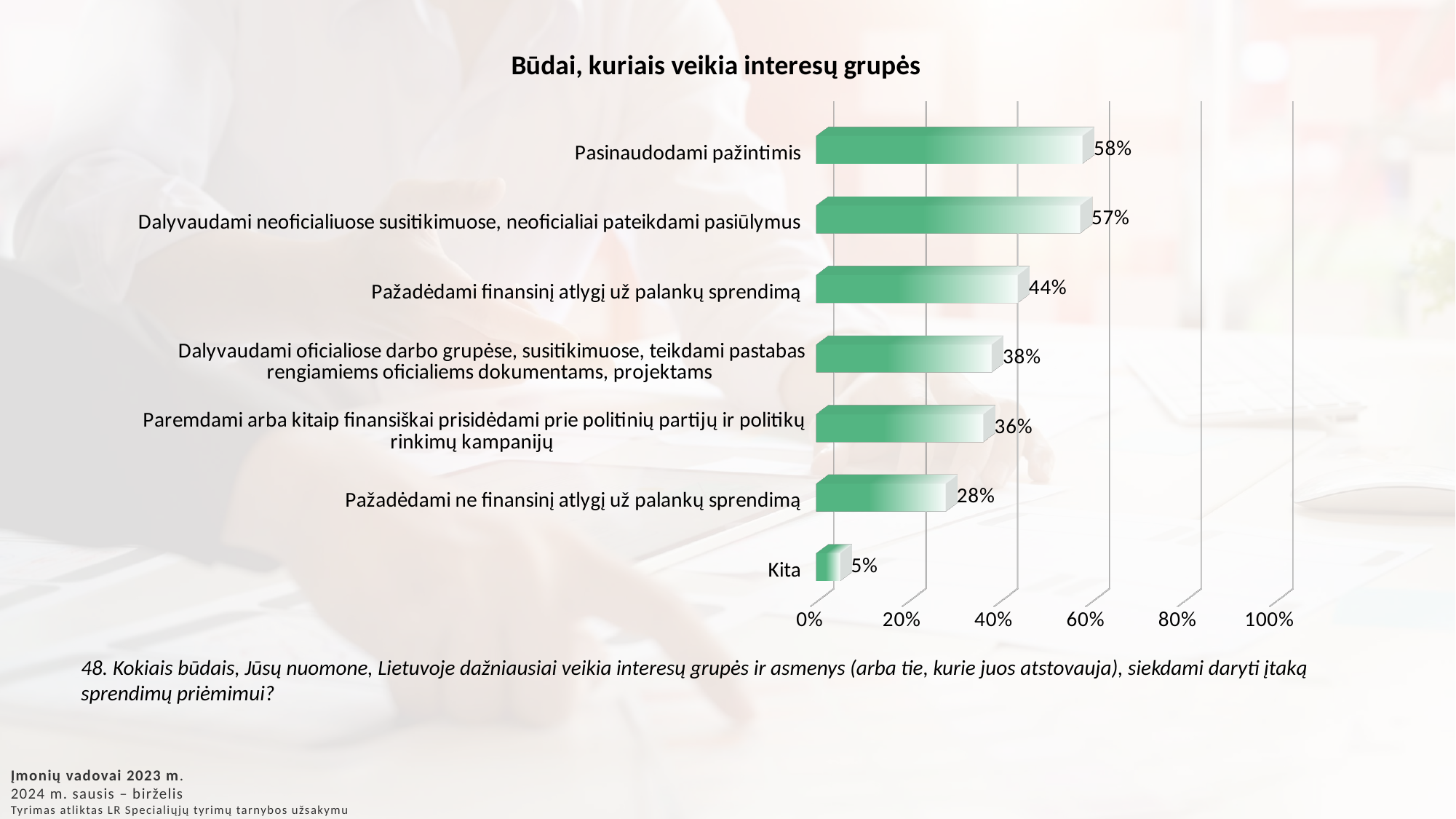
Is the value for "Paremdami arba kitaip finansiškai prisidėdami prie politinių partijų ir politikų rinkimų kampanijų" greater or less than 40%? less What kind of chart is shown on the slide? Bar chart Which category has the lowest value? Kita What is the value for "Pažadėdami finansinį atlygį už palankų sprendimą"? 44% How many categories are shown in the chart? 7 What is the value for "Pažadėdami ne finansinį atlygį už palankų sprendimą"? 28% Which category has the highest value? Pasinaudodami pažintimis What is the value for "Pasinaudodami pažintimis"? 58% What is the value for "Kita"? 5% Which is larger: the value for "Pažadėdami finansinį atlygį už palankų sprendimą" or the value for "Pažadėdami ne finansinį atlygį už palankų sprendimą"? Pažadėdami finansinį atlygį už palankų sprendimą What is the title of the chart? Būdai, kuriais veikia interesų grupės What is the difference between the values for "Pasinaudodami pažintimis" and "Pažadėdami finansinį atlygį už palankų sprendimą"? 14%